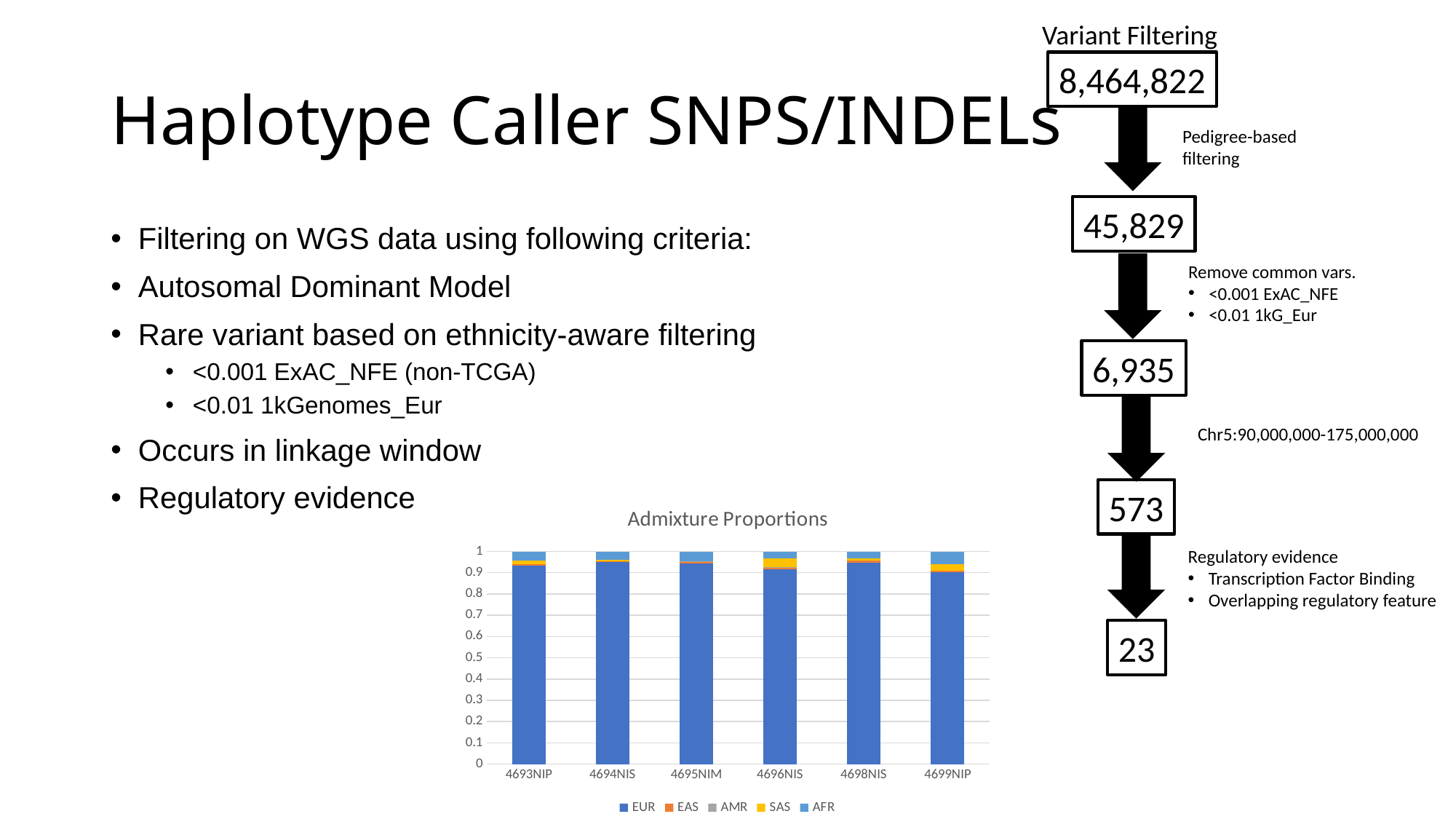
Is the EUR value for 4694NIS greater or less than 0.9? greater How many samples (categories) are shown on the x axis of the Admixture Proportions chart? 6 What is the title of the chart on the slide? Admixture Proportions What is the maximum value shown on the y axis of the Admixture Proportions chart? 1 Which series makes up the largest portion of every bar in the Admixture Proportions chart? EUR Is the AFR value for 4694NIS greater or less than 0.1? less Is the EUR value for 4699NIP greater or less than 0.7? greater What kind of chart is the Admixture Proportions chart? stacked bar chart Which series is listed first in the legend of the Admixture Proportions chart? EUR How many series does the legend of the Admixture Proportions chart list? 5